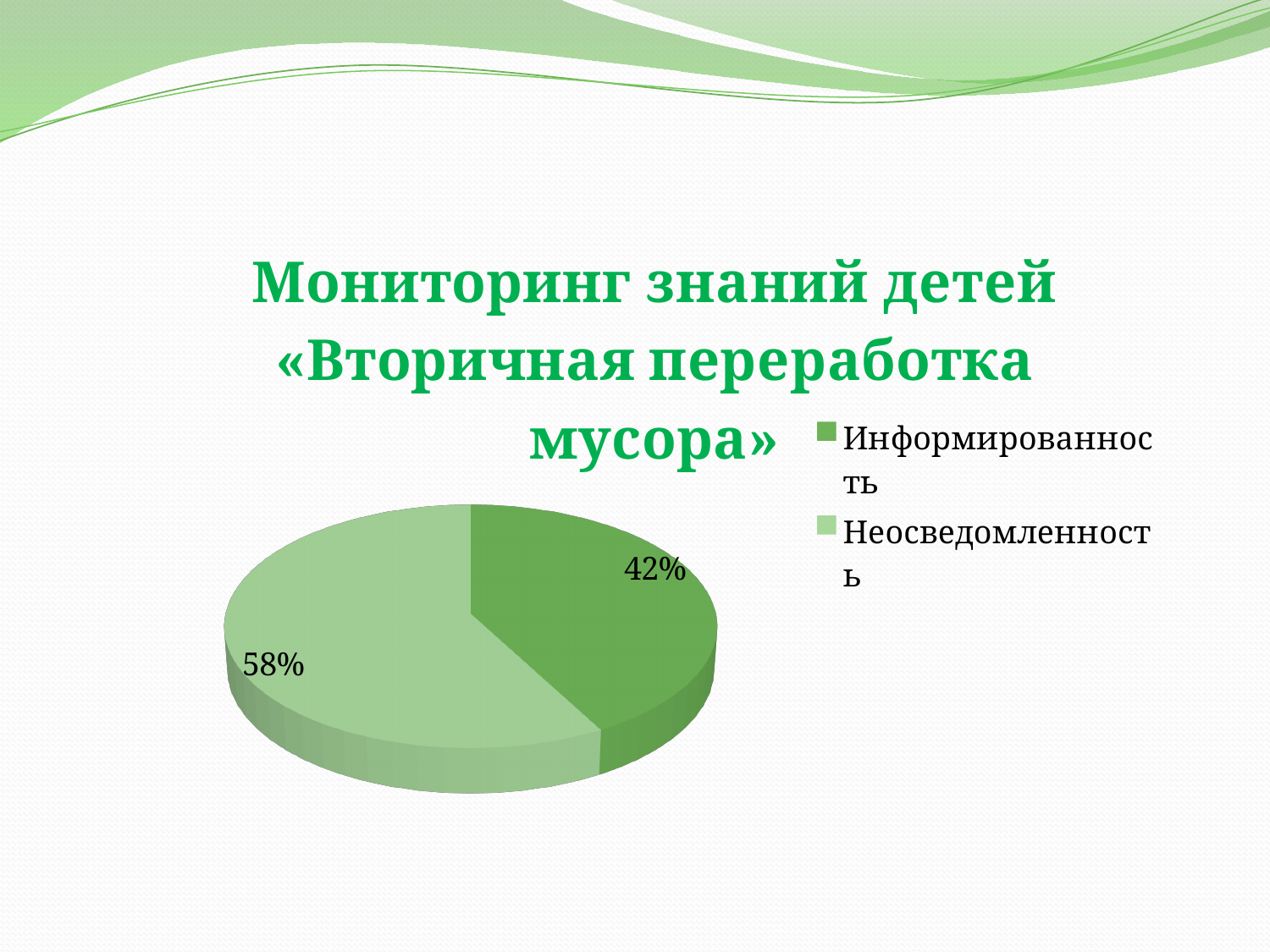
How many slices does the pie chart have? 2 What is the title of the chart? Мониторинг знаний детей «Вторичная переработка мусора» Which legend entry is shown in the darker green colour? Информированность What kind of chart is shown on the slide? pie chart How many entries does the legend list? 2 Which category has the smallest share of the pie? Информированность Which is larger, the share for Информированность or the share for Неосведомленность? Неосведомленность Is the share for Информированность greater or less than 50%? less What is the difference between the shares for Неосведомленность and Информированность? 16% What is the value for Неосведомленность? 58% What is the value for Информированность? 42% Which category has the largest share of the pie? Неосведомленность